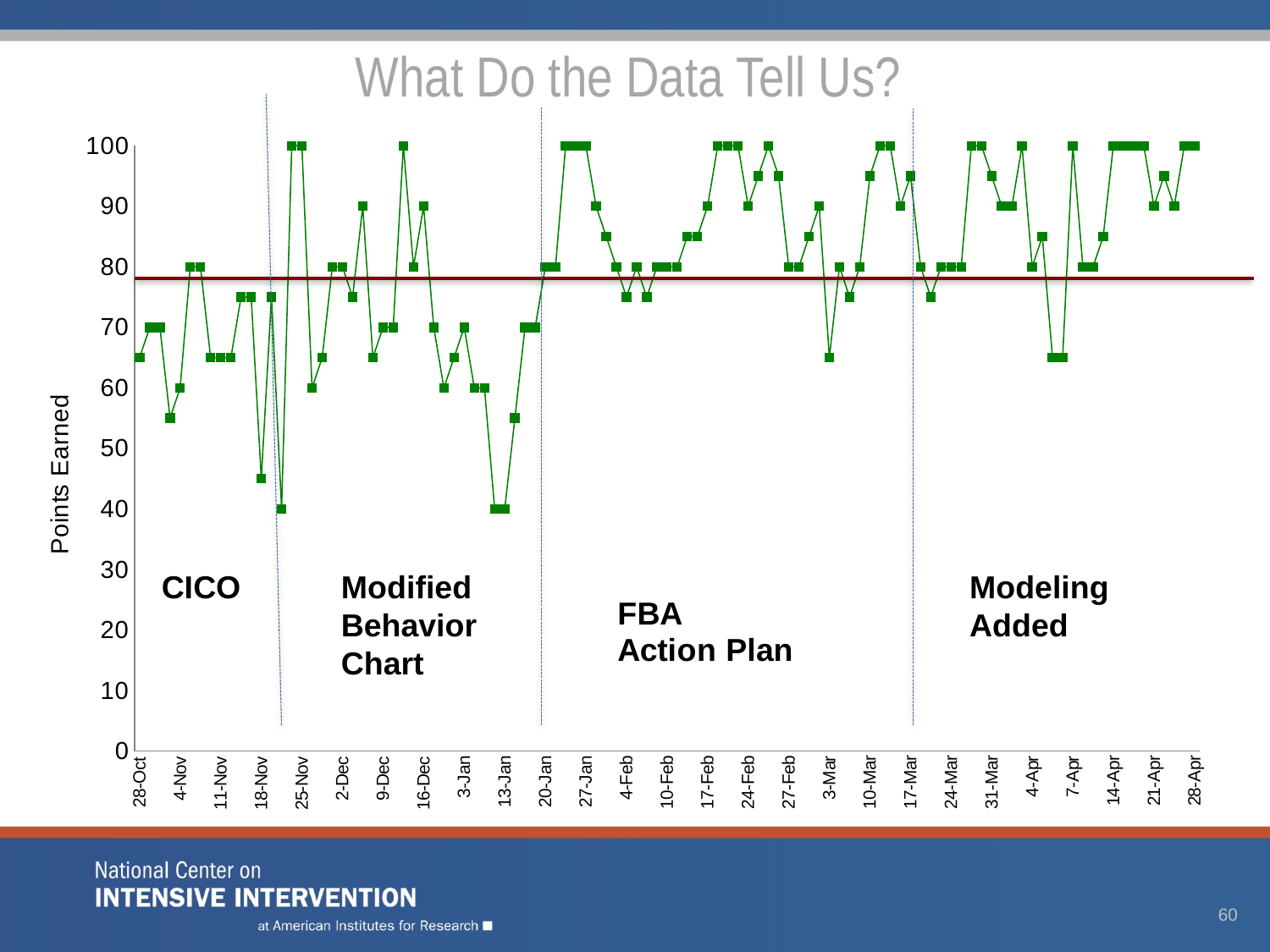
What are the four phase labels written on the chart, from left to right? CICO, Modified Behavior Chart, FBA Action Plan, Modeling Added Do the points earned generally rise or fall from the CICO phase to the Modeling Added phase? rise What kind of chart is shown on the slide? line chart Which is larger, the value at 28-Oct or the value at 28-Apr? 28-Apr What is the lowest value reached by the plotted line? 40 What is the highest tick value shown on the y-axis? 100 How many intervention phases are labeled on the chart? 4 What is the value of the last plotted point, at 28-Apr? 100 Is the value for the last plotted point, at 28-Apr, greater or less than 90? greater What is the label on the y-axis of the chart? Points Earned Is the value for the first plotted point, at 28-Oct, greater or less than 80? less What is the highest value reached by the plotted line? 100